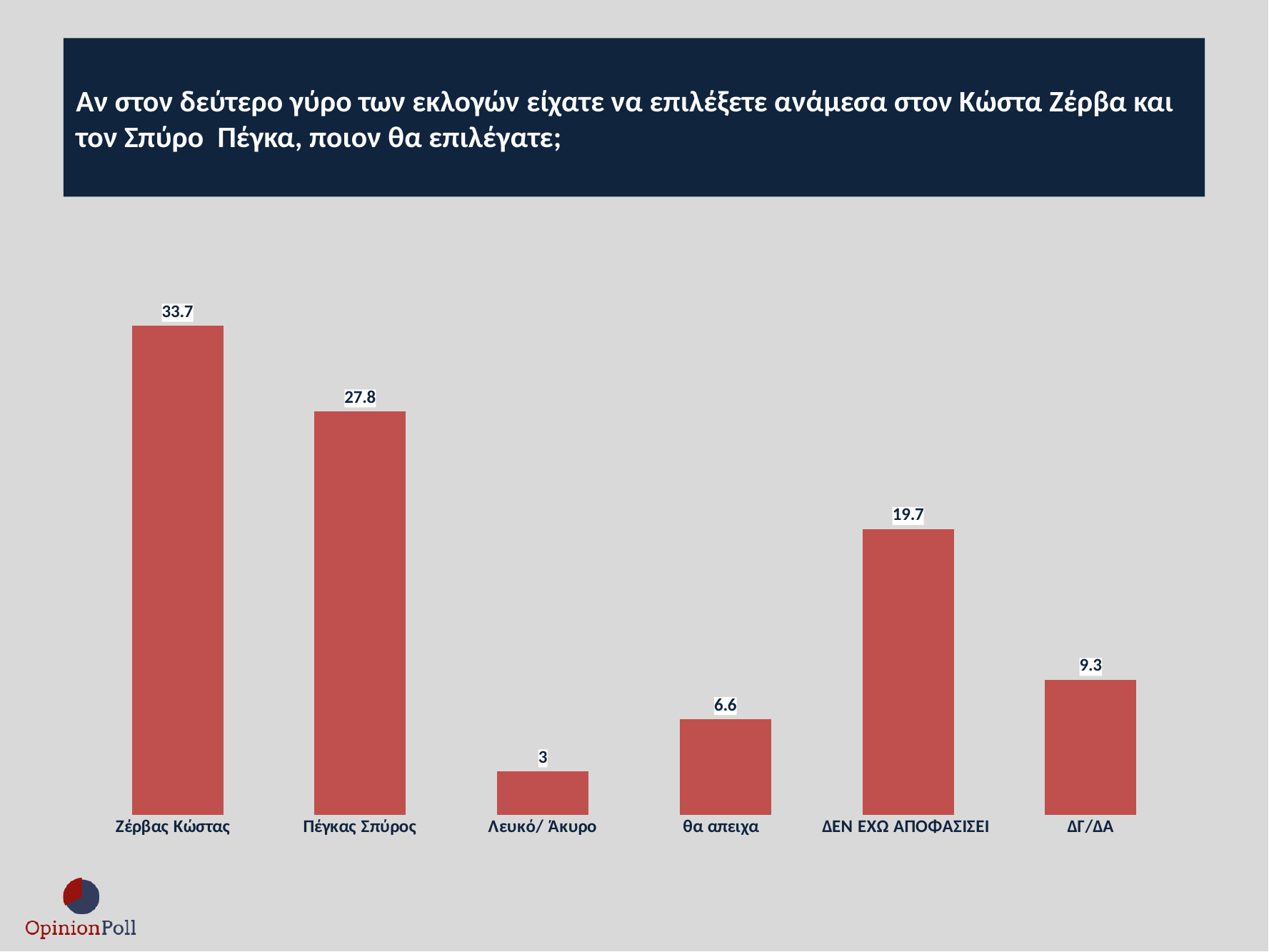
What is the value for Ζέρβας Κώστας? 33.7 Which category has the highest value? Ζέρβας Κώστας What is the value for ΔΕΝ ΕΧΩ ΑΠΟΦΑΣΙΣΕΙ? 19.7 What is the difference between the values for ΔΕΝ ΕΧΩ ΑΠΟΦΑΣΙΣΕΙ and ΔΓ/ΔΑ? 10.4 How many categories are shown in the chart? 6 Which category has the lowest value? Λευκό/ Άκυρο What colour are the bars in the chart? Red What is the value for Λευκό/ Άκυρο? 3 What is the difference between the values for Ζέρβας Κώστας and Πέγκας Σπύρος? 5.9 Which is larger, the value for θα απειχα or the value for ΔΓ/ΔΑ? ΔΓ/ΔΑ What kind of chart is shown on the slide? Bar chart What is the value for Πέγκας Σπύρος? 27.8